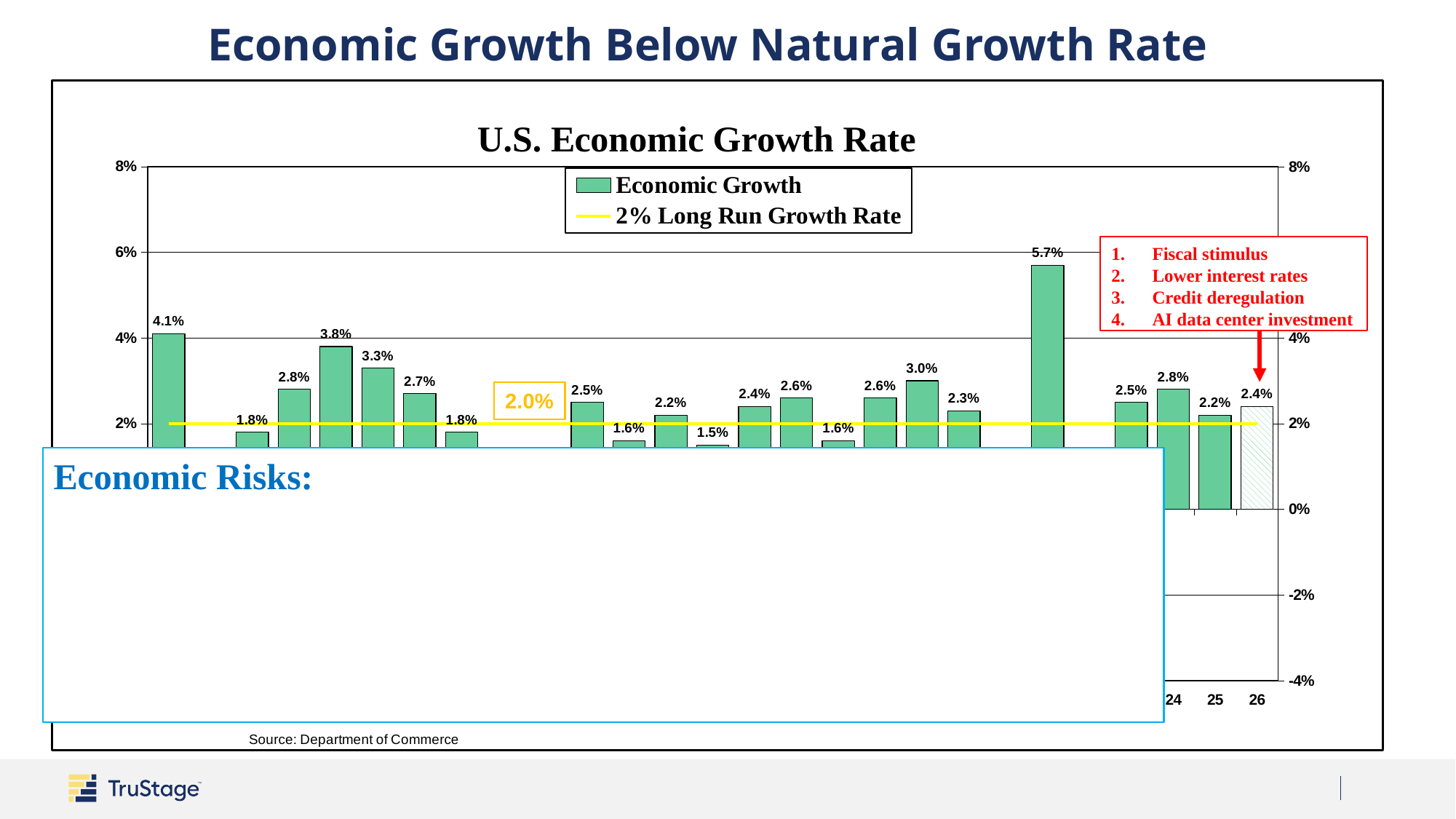
What is the title of the chart? U.S. Economic Growth Rate What is the economic growth rate for 26? 2.4% What value does the yellow horizontal line represent? 2.0% What kind of chart is used to show Economic Growth? bar chart What is the economic growth rate for 24? 2.8% What is the highest economic growth rate labeled on the chart? 5.7% What is the difference between the growth rates for 24 and 25? 0.6% Which has the higher growth rate, 24 or 26? 24 Is the growth rate for 26 greater or less than 2%? greater How many series does the legend list? 2 What is the economic growth rate for 25? 2.2% Does the growth rate rise or fall from 24 to 25? fall